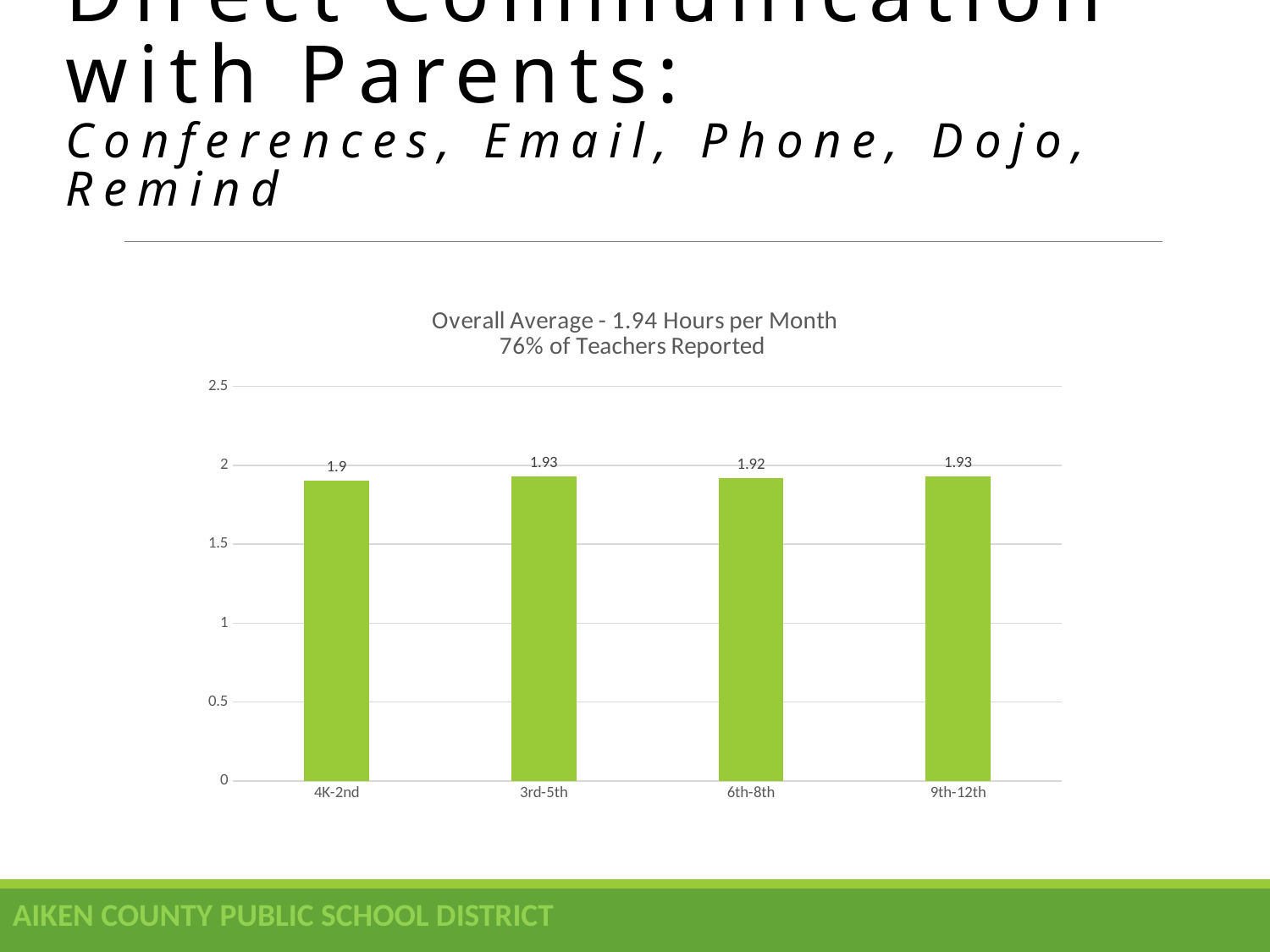
What is the value for 6th-8th? 1.92 What is the value for 4K-2nd? 1.9 What kind of chart is shown on the slide? bar chart According to the chart title, what percentage of teachers reported? 76% Is the value for 9th-12th greater or less than 2? less What is the value for 9th-12th? 1.93 What is the value for 3rd-5th? 1.93 Which is larger, the value for 6th-8th or the value for 4K-2nd? 6th-8th What is the difference between the values for 3rd-5th and 4K-2nd? 0.03 Which grade band has the lowest value? 4K-2nd How many grade bands are shown on the chart? 4 According to the chart title, what is the overall average in hours per month? 1.94